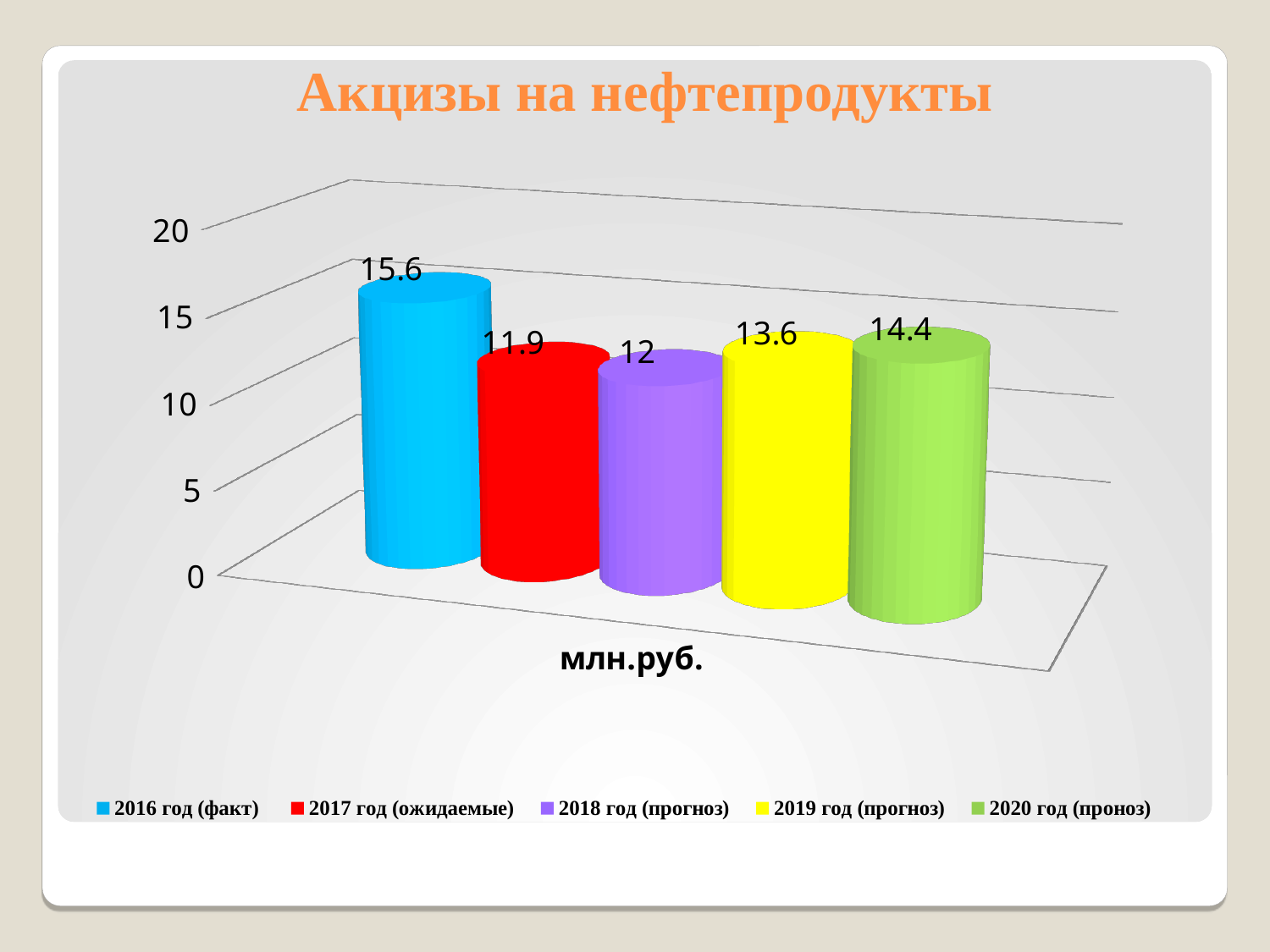
What is the value for 2020 год (проноз)? 14.4 What is the value for 2018 год (прогноз)? 12 Which series has the highest value? 2016 год (факт) Which series has the lowest value? 2017 год (ожидаемые) What kind of chart is shown on the slide? bar chart What is the difference between the values for 2016 год (факт) and 2017 год (ожидаемые)? 3.7 Which is larger, the value for 2019 год (прогноз) or 2020 год (проноз)? 2020 год (проноз) Is the value for 2016 год (факт) greater or less than 15? greater How many bars are plotted on the chart? 5 What is the title of the chart? Акцизы на нефтепродукты What is the value for 2016 год (факт)? 15.6 How many series does the legend list? 5